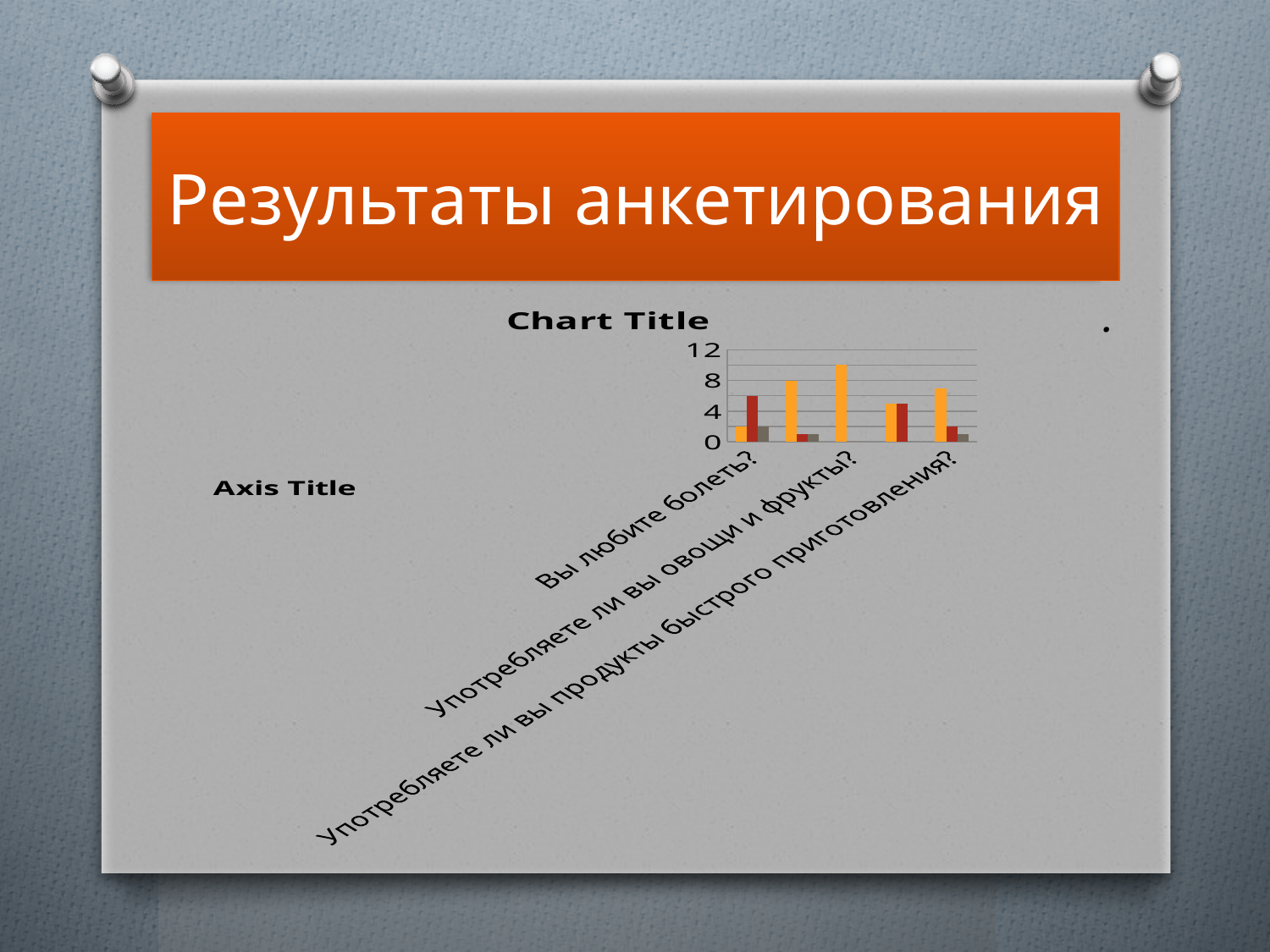
Is the tallest bar in the chart greater or less than 12? less What kind of chart is shown on the slide? bar chart Is the tallest bar in the chart greater or less than 8? greater What is the highest value shown on the chart's vertical axis? 12 What is the title of the chart on the slide? Chart Title